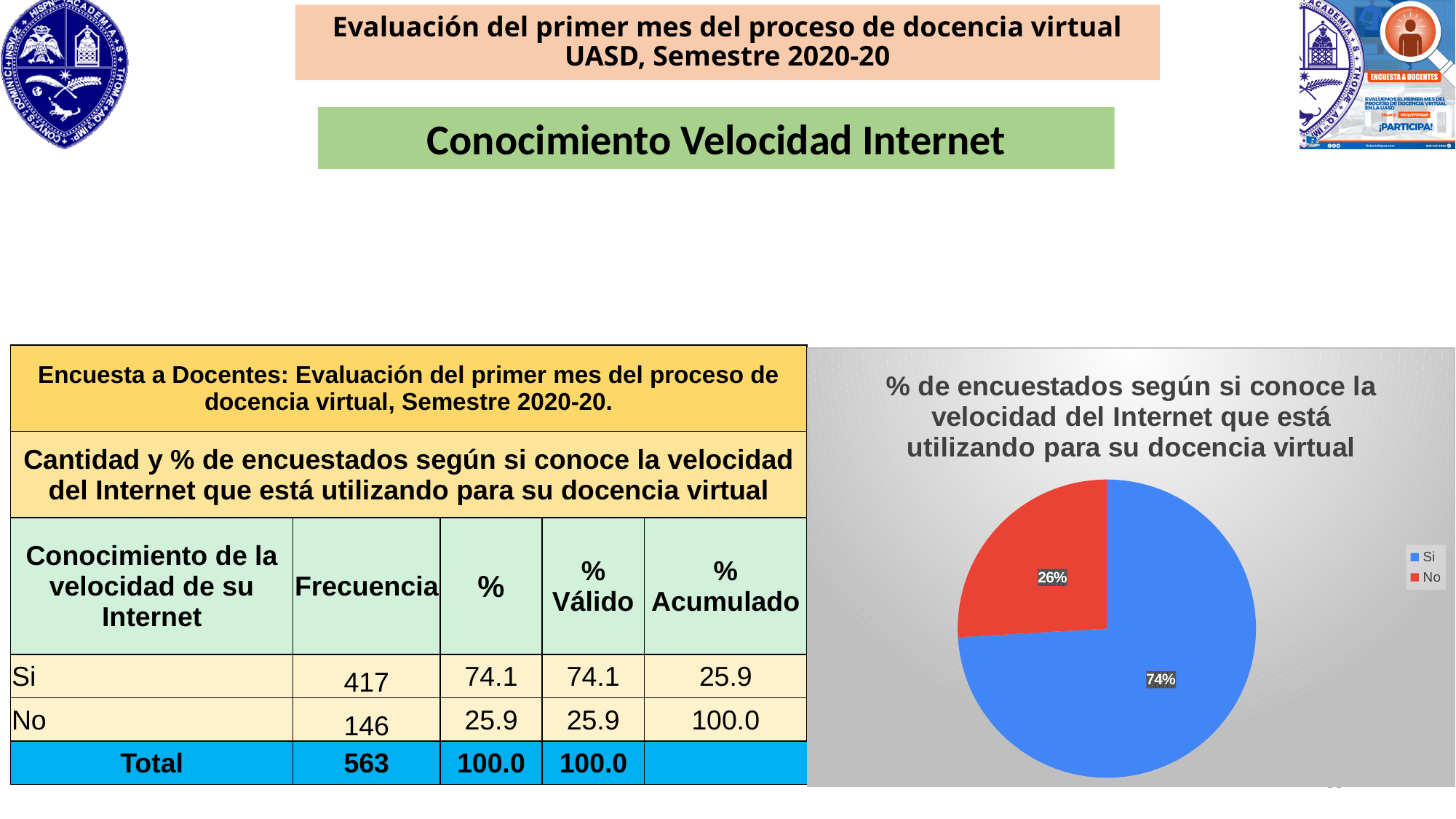
What colour is the "Si" slice in the pie chart? blue Which slice of the pie chart is the smallest? No What percentage of the pie chart does the "Si" slice represent? 74% How many entries does the pie chart's legend list? 2 What kind of chart is shown on the slide? pie chart How many slices does the pie chart have? 2 What is the difference in percentage points between the "Si" and "No" slices of the pie chart? 48% Which is larger in the pie chart, the "Si" slice or the "No" slice? Si What percentage of the pie chart does the "No" slice represent? 26% What share of the pie does the "No" slice take? 26% Which slice of the pie chart is the largest? Si What is the title of the pie chart? % de encuestados según si conoce la velocidad del Internet que está utilizando para su docencia virtual